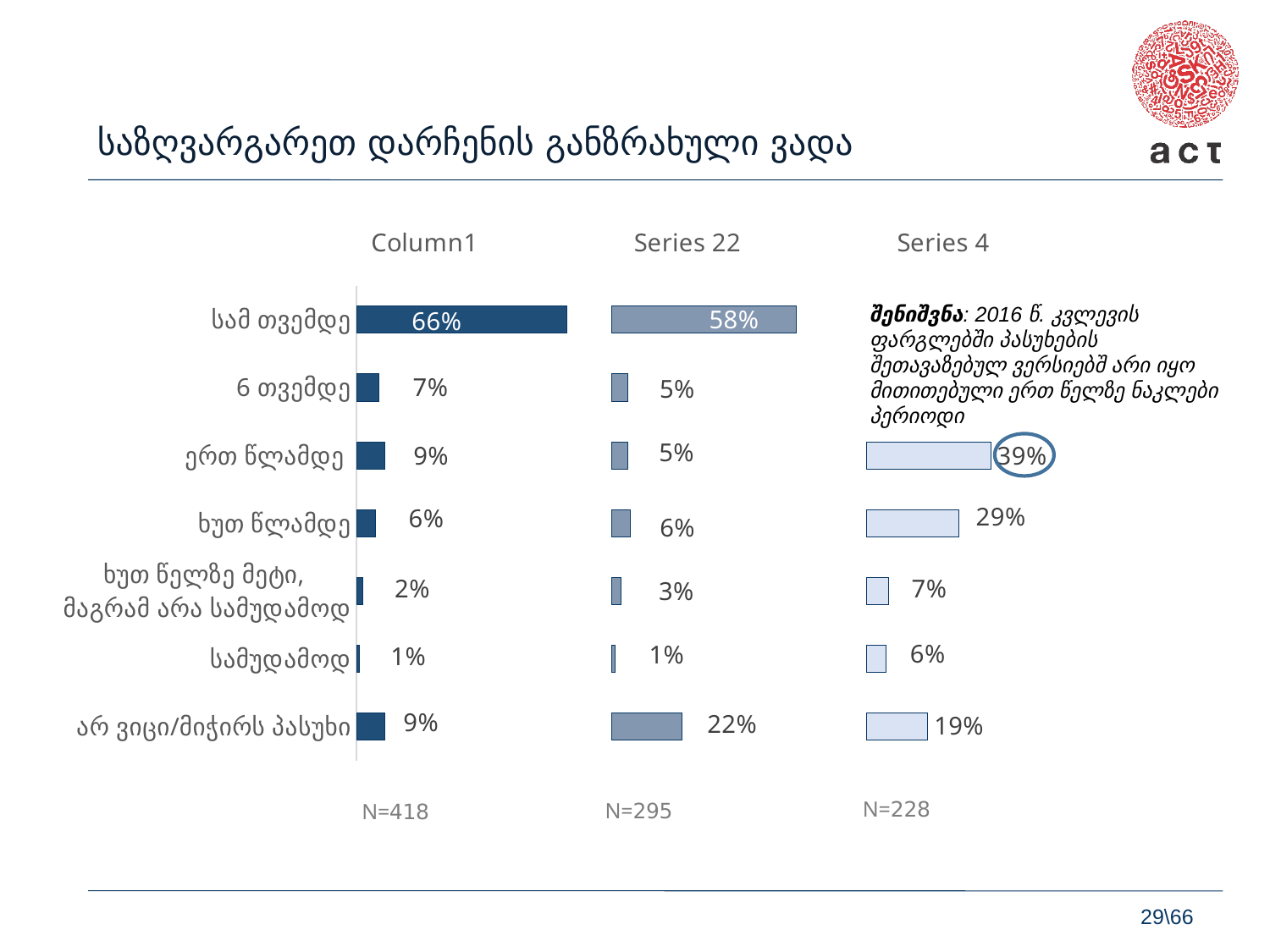
What kind of chart is shown on the slide? Bar chart What is the value for არ ვიცი/მიჭირს პასუხი in the Series 22 series? 22% How many categories are listed on the chart? 7 Which category has the lowest value in the Series 22 series? სამუდამოდ What is the difference between the Column1 and Series 22 values for სამ თვემდე? 8% What is the sample size (N) shown for the Series 4 series? N=228 What is the value for ხუთ წლამდე in the Series 4 series? 29% What is the value for სამ თვემდე in the Column1 series? 66% What is the value for ერთ წლამდე in the Series 4 series? 39% Which is larger for არ ვიცი/მიჭირს პასუხი: the Column1 value or the Series 22 value? Series 22 Which category has the highest value in the Column1 series? სამ თვემდე How many series does the chart show? 3